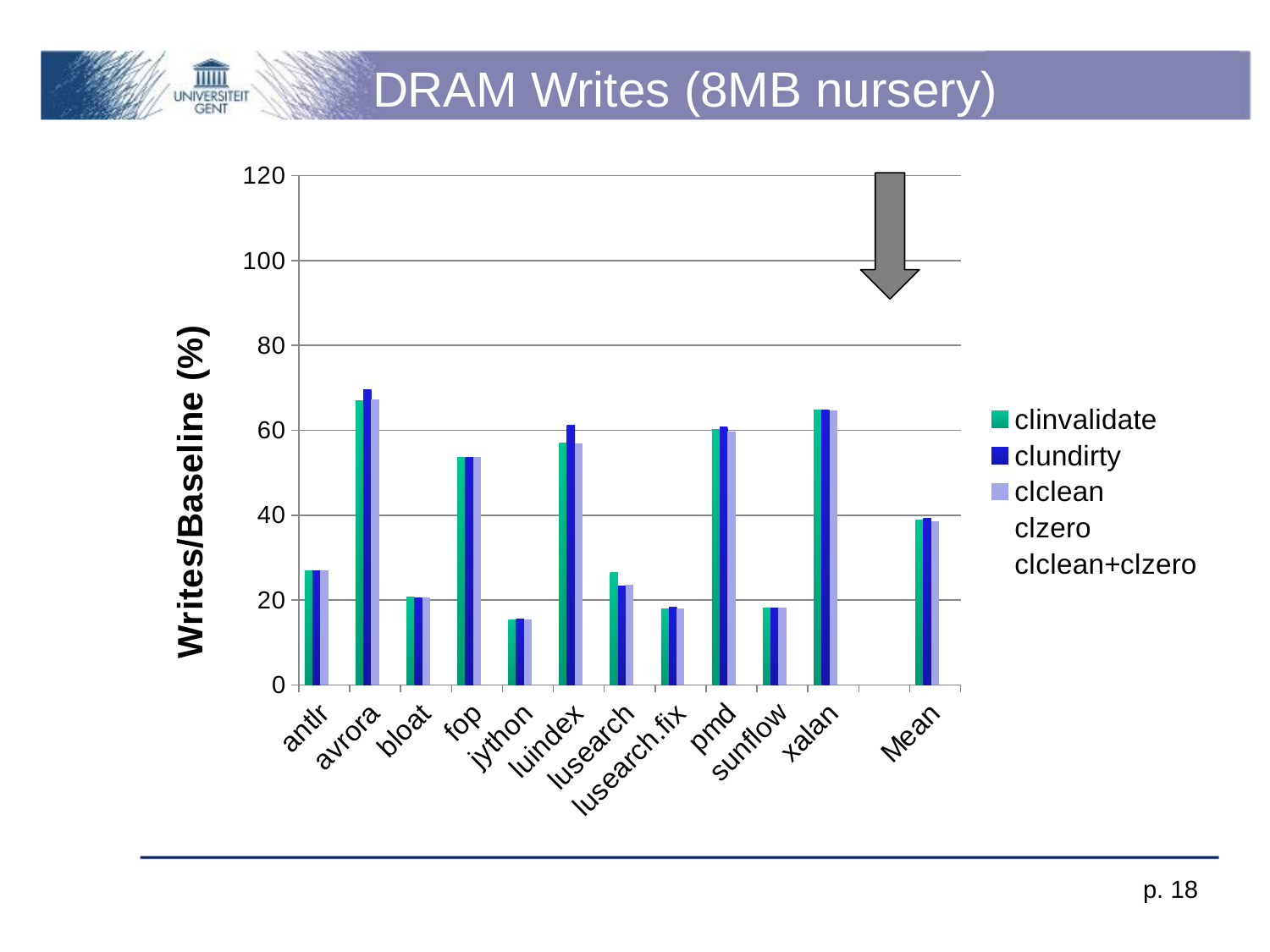
Is the clundirty value for avrora greater or less than 60? greater Is the clclean value for xalan greater or less than 60? greater Is the clinvalidate value for fop greater or less than 40? greater How many categories are shown along the x axis? 12 Which benchmark has the highest Writes/Baseline values? avrora How many series does the legend list? 5 Which benchmark has the lowest Writes/Baseline values? jython Which has the larger clundirty value, luindex or fop? luindex What is the label of the vertical axis? Writes/Baseline (%) What kind of chart is shown on the slide? bar chart What is the title of the chart? DRAM Writes (8MB nursery)